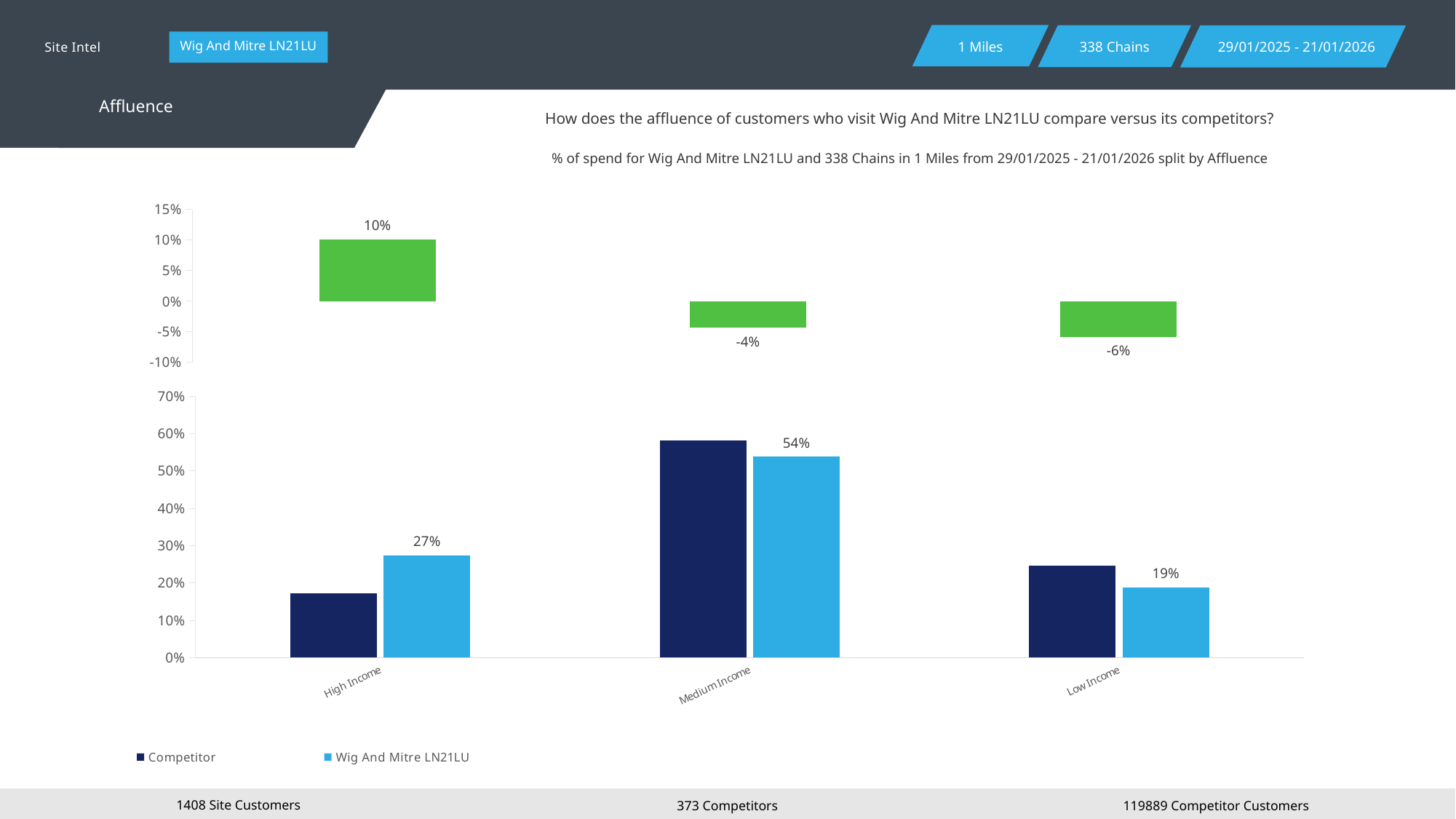
In the top chart, which category has the lowest value? Low Income In the top chart, do the values rise or fall from High Income to Low Income? fall In the bottom chart, what is the difference between the Wig And Mitre LN21LU values for High Income and Low Income? 8% What kind of chart is the bottom chart? bar chart In the top chart, what is the value for Low Income? -6% In the bottom chart, is the Competitor value for Medium Income greater or less than 50%? greater In the bottom chart, what is the value for Wig And Mitre LN21LU in Medium Income? 54% In the top chart, which category has the highest value? High Income In the top chart, what is the value for High Income? 10% In the bottom chart, for High Income, which series has the larger value: Competitor or Wig And Mitre LN21LU? Wig And Mitre LN21LU How many series does the legend of the bottom chart list? 2 In the bottom chart, what is the value for Wig And Mitre LN21LU in Low Income? 19%